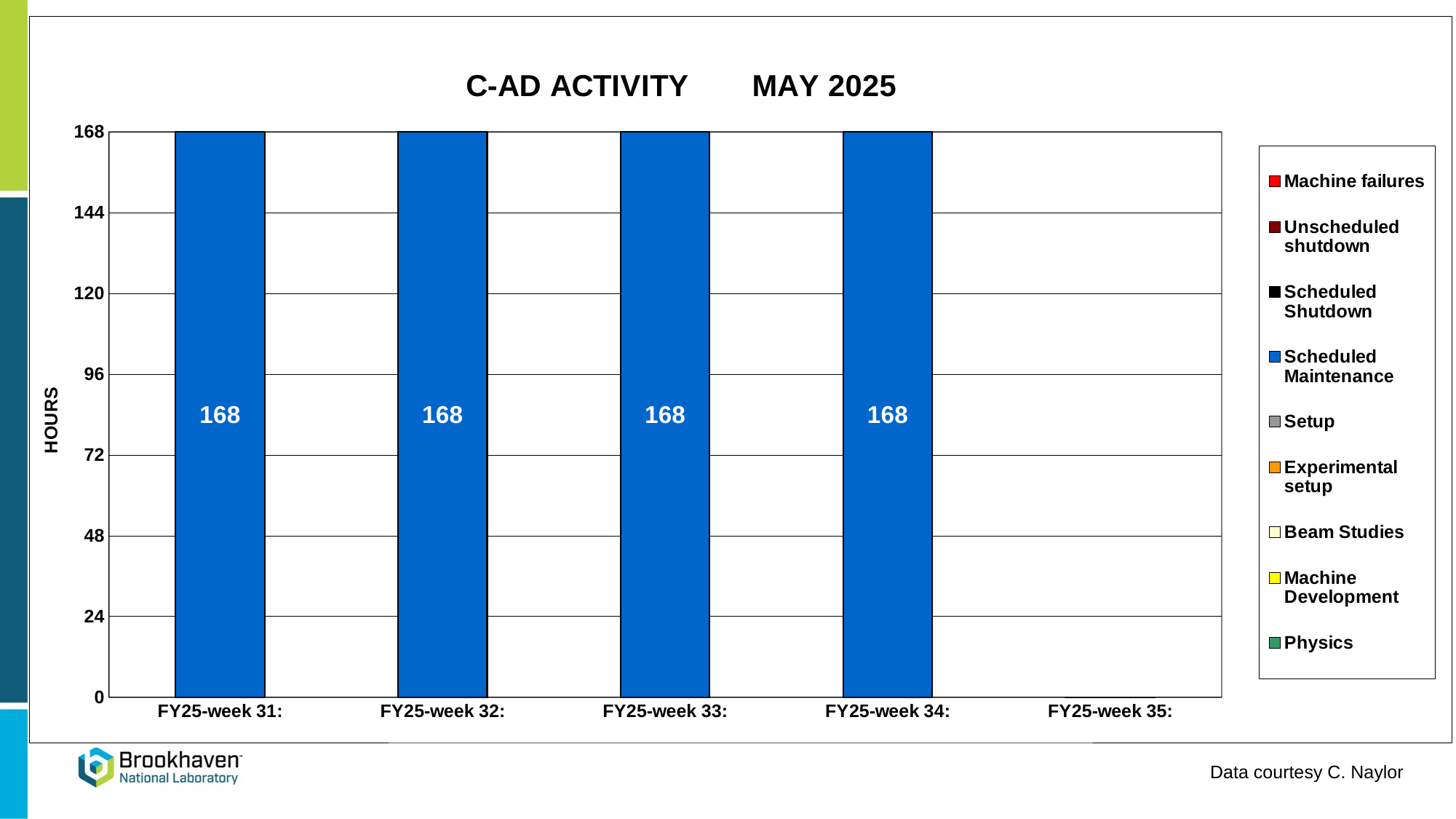
What is the value for FY25-week 33? 168 Is the value for FY25-week 35 greater or less than 24? less What is the difference between the values for FY25-week 31 and FY25-week 32? 0 How many week categories are shown on the x axis? 5 What is the label on the y axis? HOURS What is the title of the chart? C-AD ACTIVITY MAY 2025 What type of chart is shown on the slide? bar chart What is the value for FY25-week 34? 168 Is the value for FY25-week 33 greater or less than 144? greater How many series does the legend list? 9 What is the value for FY25-week 31? 168 Which is larger, the value for FY25-week 32 or FY25-week 35? FY25-week 32